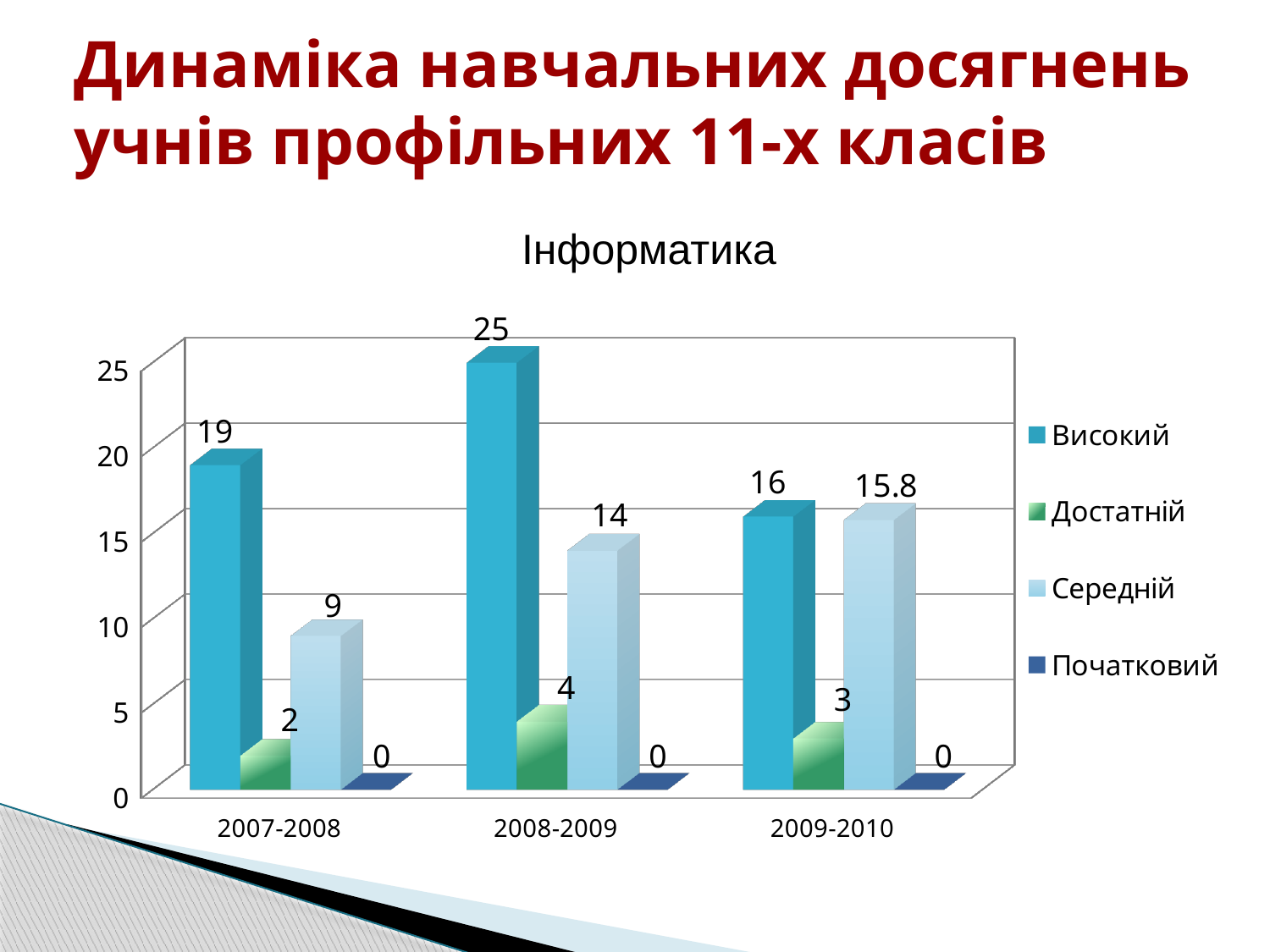
What is the difference between the Високий values for 2008-2009 and 2009-2010? 9 How many year categories are shown on the x axis? 3 In which year is the Високий value highest? 2008-2009 In which year is the Середній value lowest? 2007-2008 What is the title of the chart? Інформатика How many series does the legend list? 4 Does the Середній value rise or fall from 2007-2008 to 2009-2010? rise Which is larger in 2009-2010: Високий or Середній? Високий What is the value for Високий in 2008-2009? 25 What is the value for Середній in 2009-2010? 15.8 What is the value for Достатній in 2007-2008? 2 What kind of chart is shown? bar chart